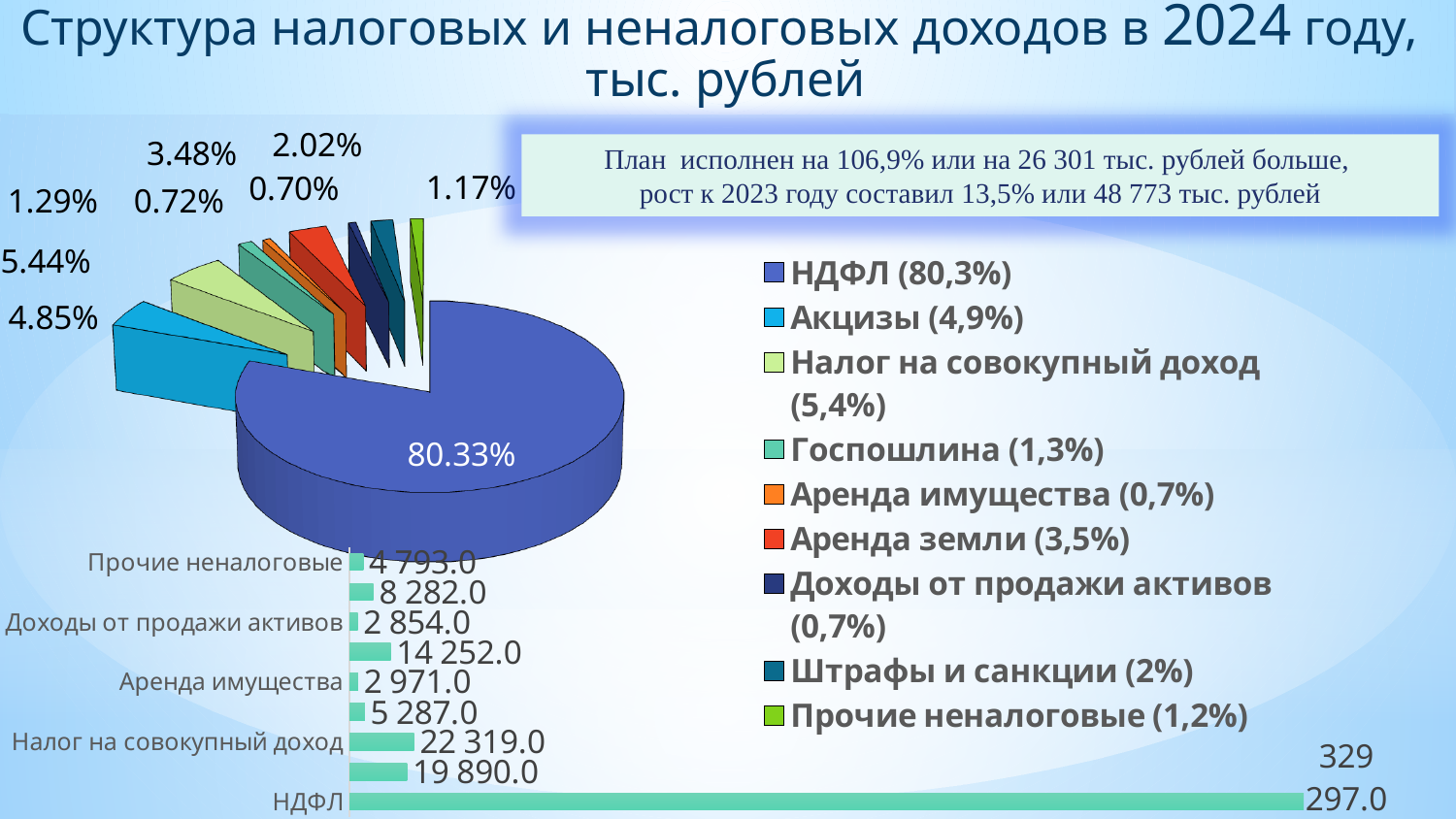
How many entries does the legend of the pie chart list? 9 In the pie chart, what percentage label is shown on the largest slice? 80.33% In the bar chart at the bottom, what is the difference between the values for Налог на совокупный доход and Прочие неналоговые? 17 526.0 In the bar chart at the bottom, what is the value for Прочие неналоговые? 4 793.0 In the bar chart at the bottom, what is the value for Доходы от продажи активов? 2 854.0 In the pie chart, which category has the largest share? НДФЛ In the bar chart at the bottom, what is the value for НДФЛ? 329 297.0 What kind of chart is the chart at the bottom of the slide with the category НДФЛ? Bar chart In the bar chart at the bottom, what is the value for Налог на совокупный доход? 22 319.0 In the bar chart at the bottom, which has the larger value: Аренда имущества or Доходы от продажи активов? Аренда имущества What kind of chart is the chart on the left side of the slide with the large blue segment? Pie chart In the bar chart at the bottom, what is the value for Аренда имущества? 2 971.0